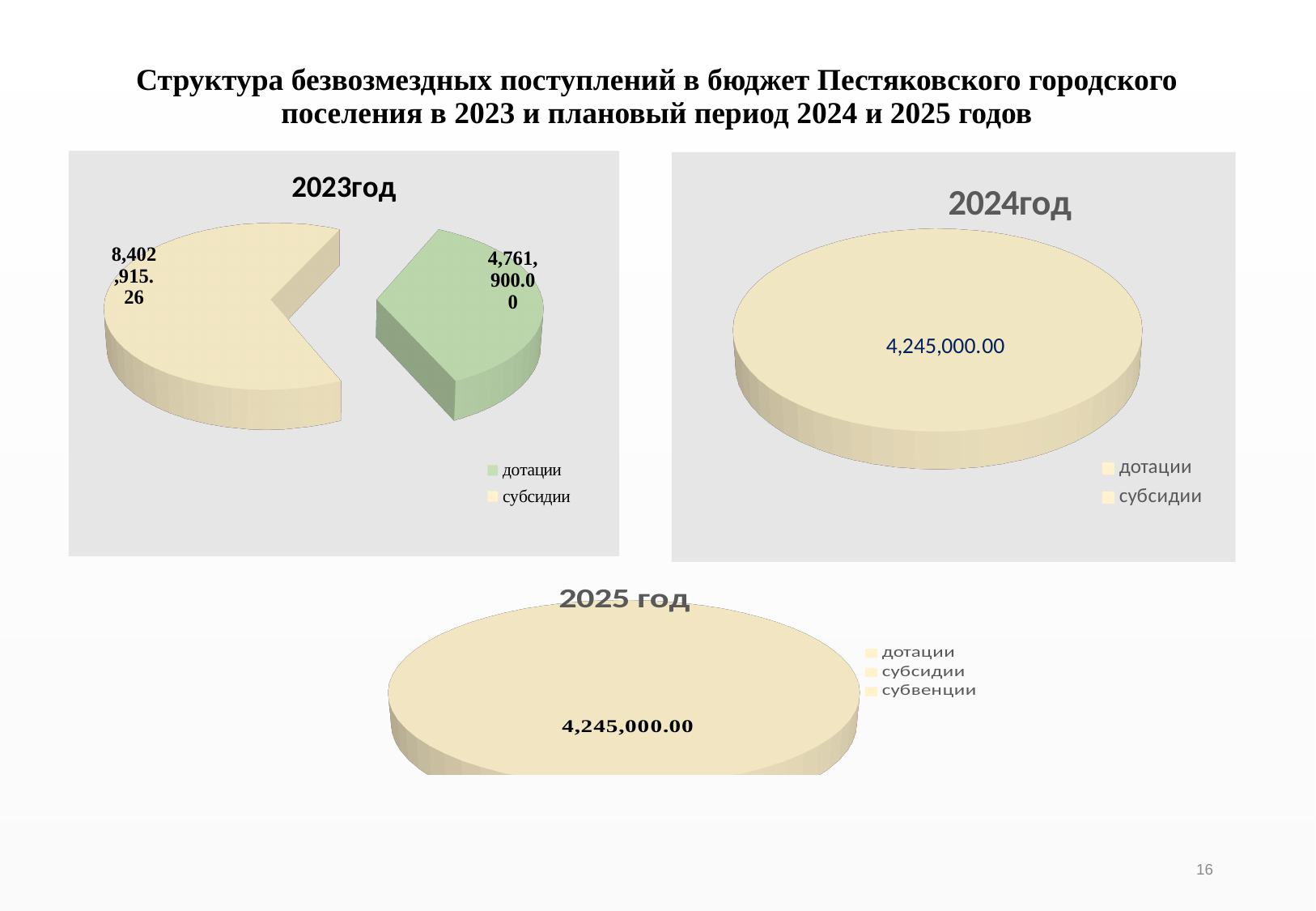
In the 2023год chart, what is the value for дотации? 4,761,900.00 In the 2023год chart, what share of the total does субсидии represent? 63.8% In the 2023год chart, what is the difference between the субсидии value and the дотации value? 3,641,015.26 How many entries does the legend of the 2025 год chart list? 3 In the 2024год chart, what value is printed on the pie? 4,245,000.00 In the 2025 год chart, what value is printed on the pie? 4,245,000.00 How many entries does the legend of the 2023год chart list? 2 In the 2023год chart, what is the total of the two slices? 13,164,815.26 In the 2023год chart, what colour is the дотации slice? green In the 2023год chart, what is the value for субсидии? 8,402,915.26 What kind of chart is the 2023год chart? pie chart In the 2023год chart, which category is larger, дотации or субсидии? субсидии